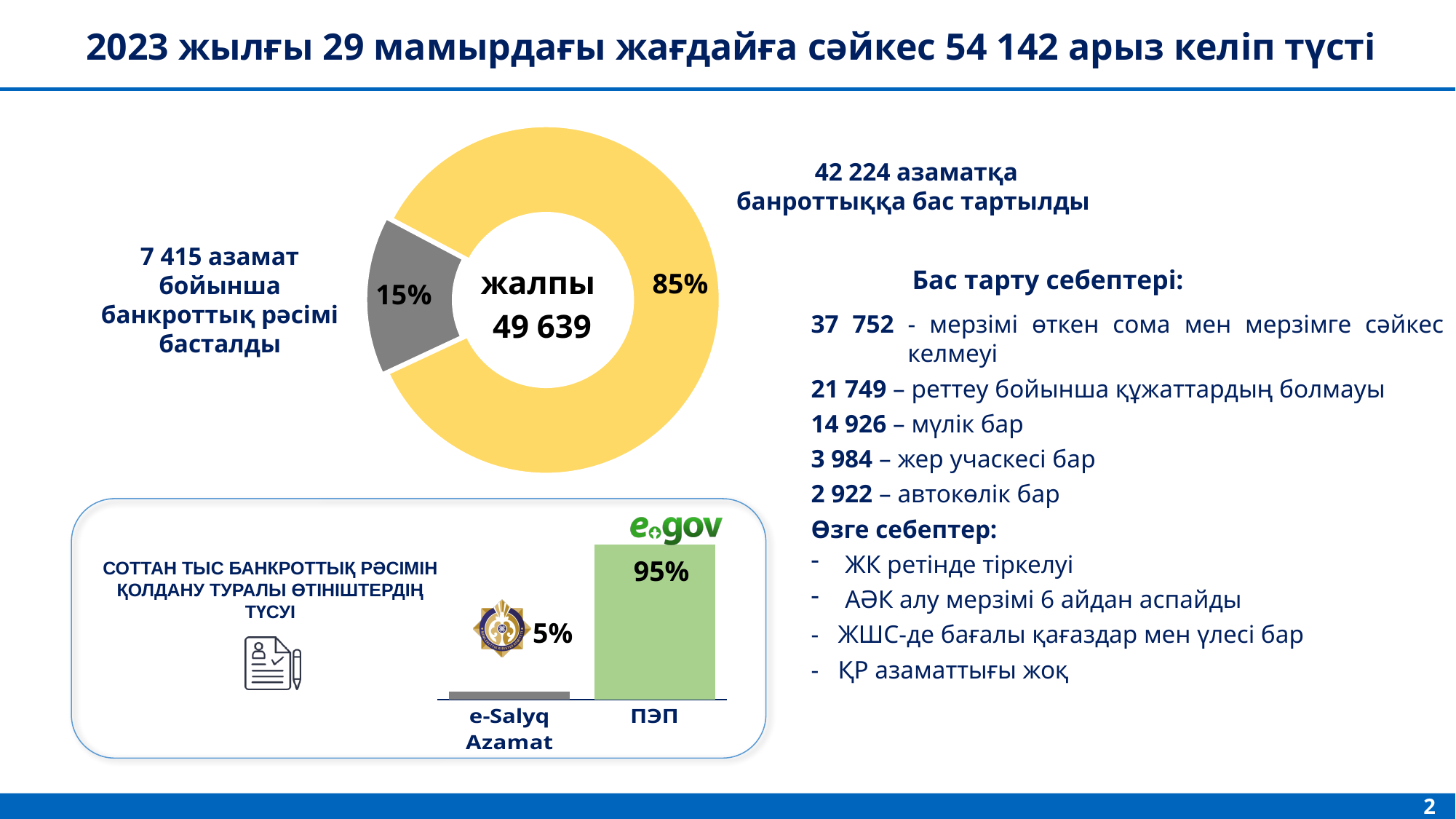
In the donut chart, what percentage is shown for the grey slice? 15% In the bottom-left bar chart, which category has the highest value? ПЭП In the bottom-left bar chart, what is the value for ПЭП? 95% In the donut chart, what percentage is shown for the yellow slice? 85% In the donut chart, what is the difference in percentage points between the yellow slice and the grey slice? 70 percentage points In the donut chart, what total value is printed in the centre under 'жалпы'? 49 639 In the bottom-left bar chart, what is the difference between the ПЭП value and the e-Salyq Azamat value? 90 percentage points How many slices does the donut chart have? 2 What kind of chart is the chart in the upper left with the label 'жалпы 49 639' in the centre? Pie (donut) chart What kind of chart is the chart in the bottom-left box titled 'СОТТАН ТЫС БАНКРОТТЫҚ РӘСІМІН ҚОЛДАНУ ТУРАЛЫ ӨТІНІШТЕРДІҢ ТҮСУІ'? Bar chart In the donut chart, which slice is larger, the grey one or the yellow one? The yellow one (85%) In the bottom-left bar chart, what is the value for e-Salyq Azamat? 5%